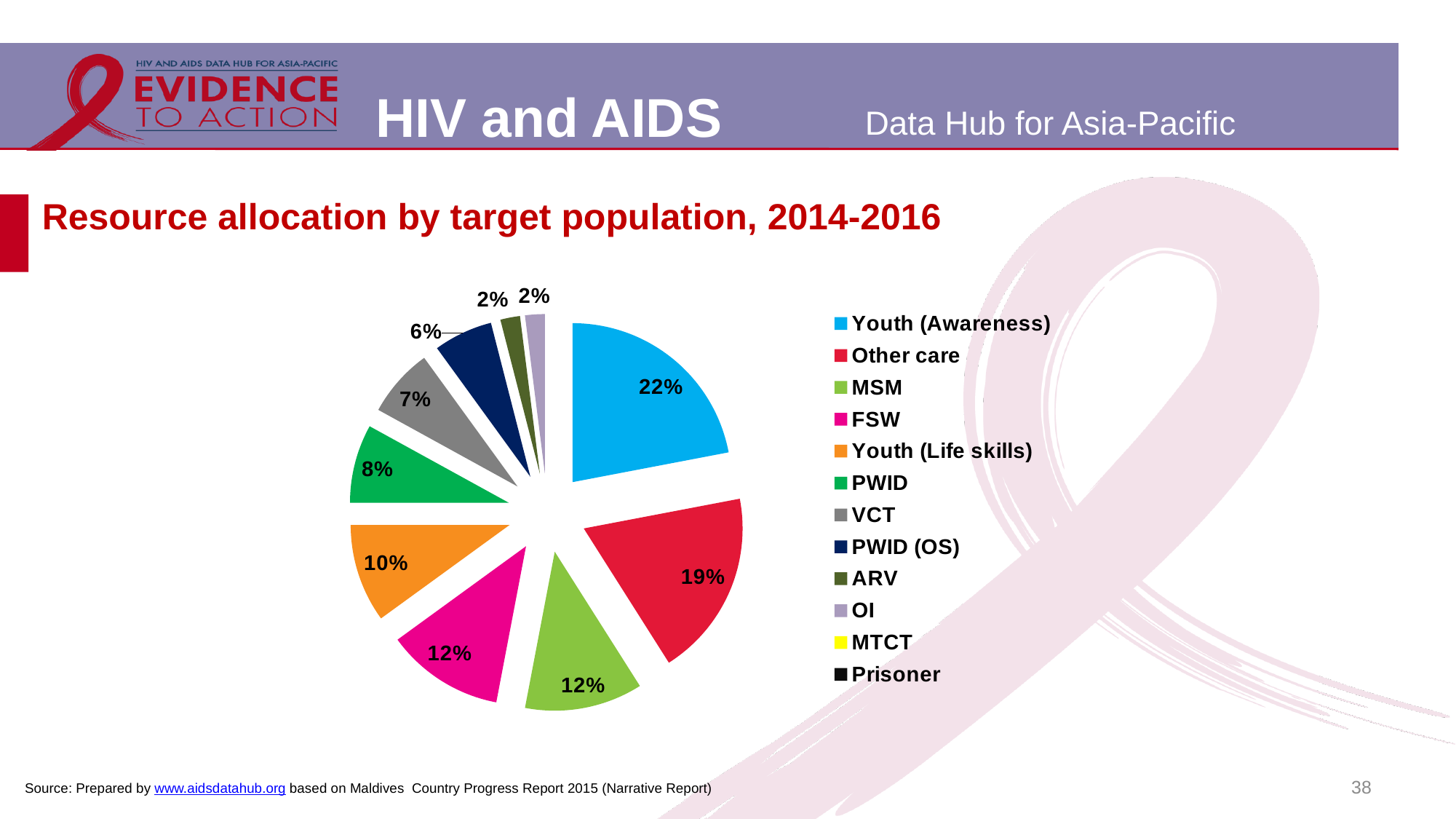
How many target populations are listed in the legend? 12 Which target population receives the largest share of resources? Youth (Awareness) What share of resources is allocated to PWID? 8% Which receives a larger share of resources, FSW or Youth (Life skills)? FSW What share of resources is allocated to VCT? 7% What type of chart is shown on the slide? Pie chart What is the title of the chart? Resource allocation by target population, 2014-2016 What share of resources is allocated to Youth (Awareness)? 22% What share of resources is allocated to Youth (Life skills)? 10% Which receives a larger share of resources, PWID or PWID (OS)? PWID What share of resources is allocated to Other care? 19% What is the difference in percentage points between the Youth (Awareness) share and the Other care share? 3